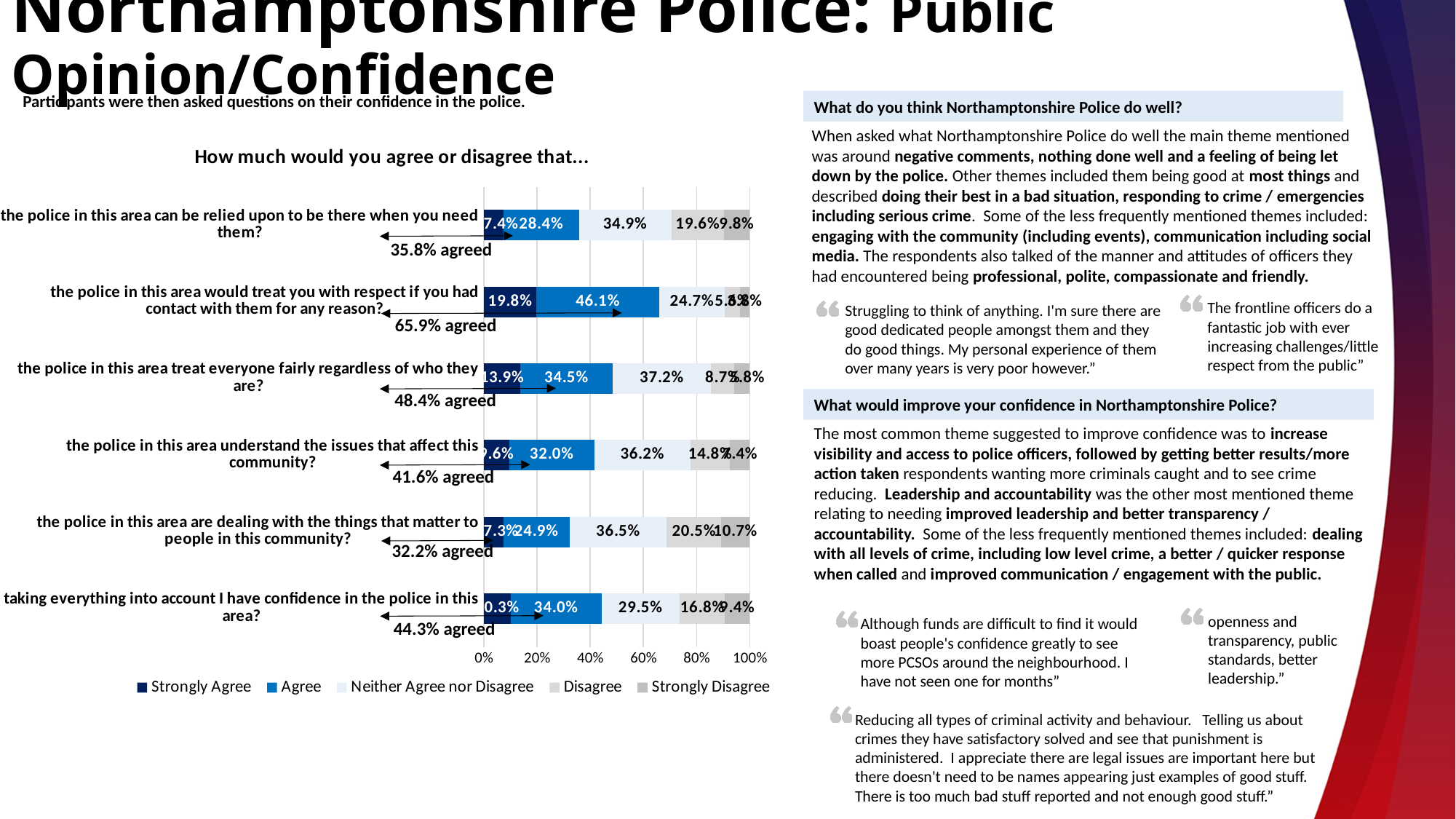
How many statements (categories) are plotted in the chart? 6 What is the Strongly Agree value for 'the police in this area would treat you with respect if you had contact with them for any reason'? 19.8% What type of chart is shown on the slide? bar chart What is the title of the chart? How much would you agree or disagree that... How many series does the chart legend list? 5 Which is larger: the Disagree value for 'dealing with the things that matter to people in this community' or the Disagree value for 'taking everything into account I have confidence in the police in this area'? dealing with the things that matter to people in this community (20.5%) What is the difference between the Agree value for 'treat you with respect' (46.1%) and the Agree value for 'dealing with the things that matter to people in this community' (24.9%)? 21.2 percentage points Which statement has the lowest annotated 'agreed' percentage? the police in this area are dealing with the things that matter to people in this community (32.2% agreed) What is the Agree value for 'the police in this area would treat you with respect if you had contact with them for any reason'? 46.1% What combined 'agreed' percentage is annotated for 'the police in this area treat everyone fairly regardless of who they are'? 48.4% agreed What is the Neither Agree nor Disagree value for 'the police in this area can be relied upon to be there when you need them'? 34.9% Which statement has the highest Agree value? the police in this area would treat you with respect if you had contact with them for any reason